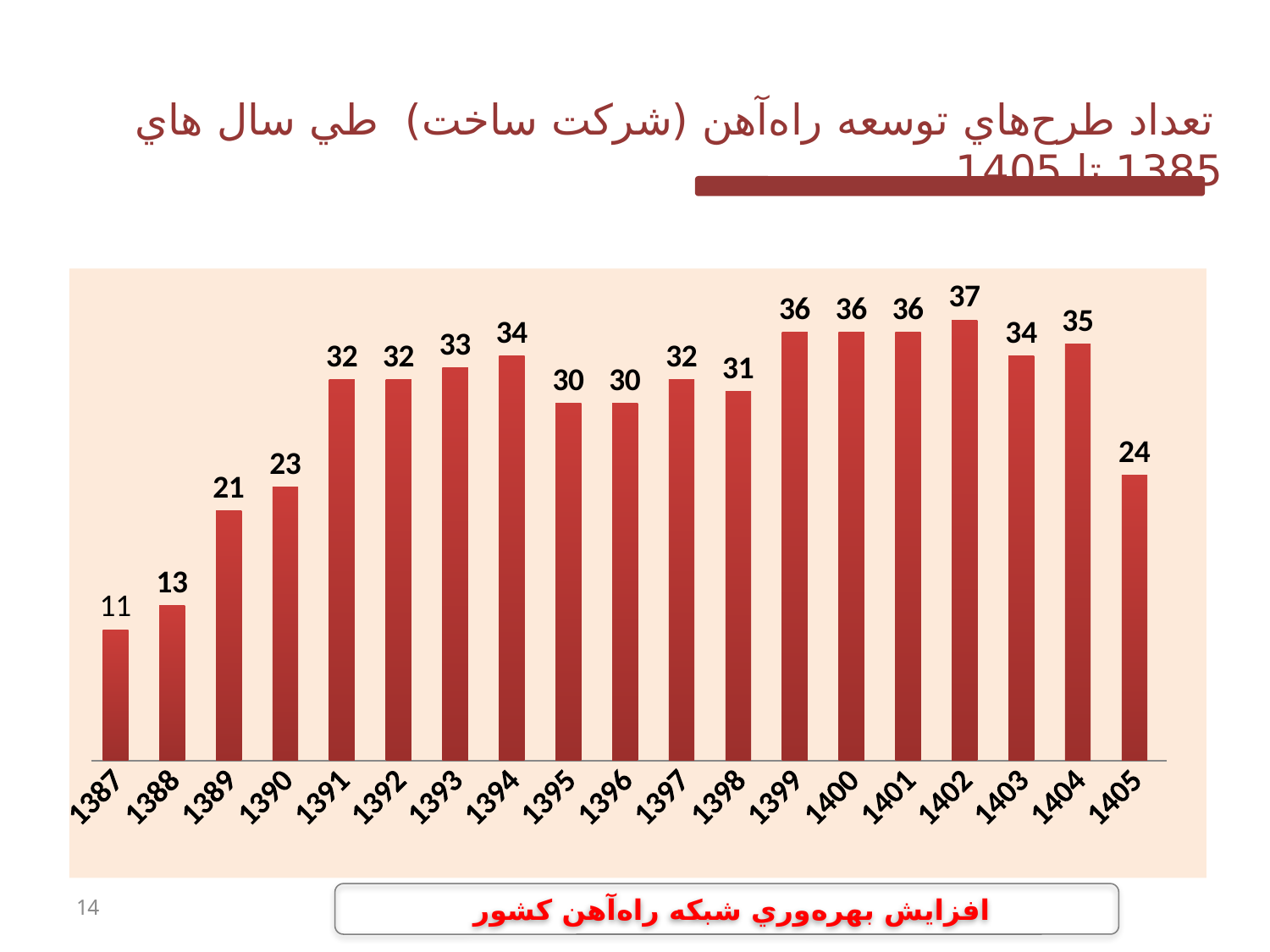
What is the value for 1387? 11 Which year has the lowest value? 1387 Which is larger, the value for 1389 or the value for 1390? 1390 How many years are shown on the x axis? 19 What is the difference between the values for 1404 and 1405? 11 What is the value for 1405? 24 What is the difference between the values for 1402 and 1387? 26 What is the value for 1402? 37 Do the values rise or fall from 1387 to 1391? rise Which year has the highest value? 1402 What kind of chart is shown on the slide? bar chart What is the value for 1394? 34